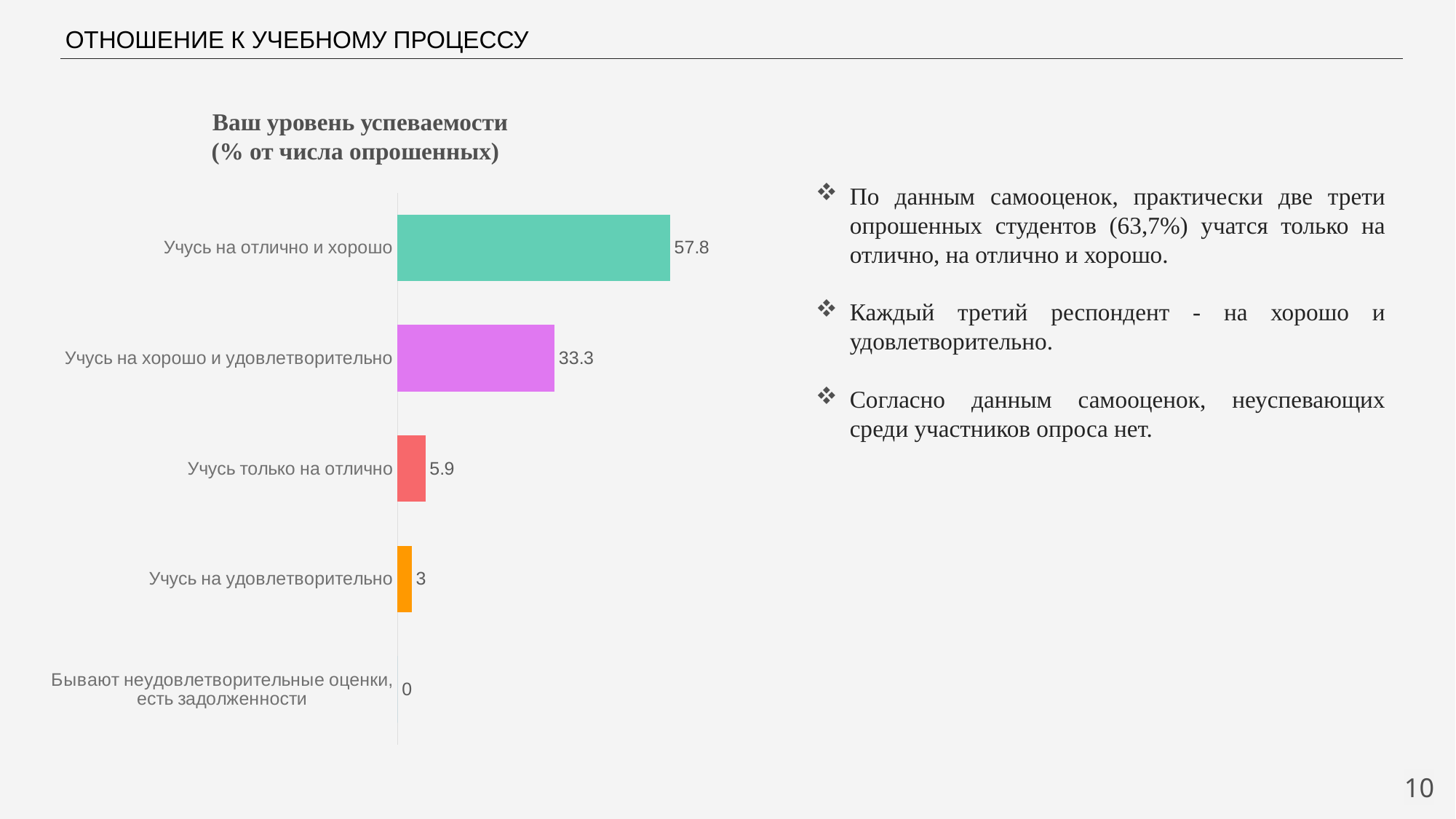
What is the difference between the values for 'Учусь на отлично и хорошо' and 'Учусь на хорошо и удовлетворительно'? 24.5 What is the value for 'Учусь только на отлично'? 5.9 Which is larger: the value for 'Учусь только на отлично' or 'Учусь на удовлетворительно'? Учусь только на отлично What is the value for 'Учусь на хорошо и удовлетворительно'? 33.3 What kind of chart is shown on the slide? Bar chart What is the value for 'Учусь на удовлетворительно'? 3 Which category has the highest value? Учусь на отлично и хорошо Which category has the lowest value? Бывают неудовлетворительные оценки, есть задолженности What is the title of the chart? Ваш уровень успеваемости (% от числа опрошенных) What is the value for 'Бывают неудовлетворительные оценки, есть задолженности'? 0 How many categories are shown in the chart? 5 What is the value for 'Учусь на отлично и хорошо'? 57.8